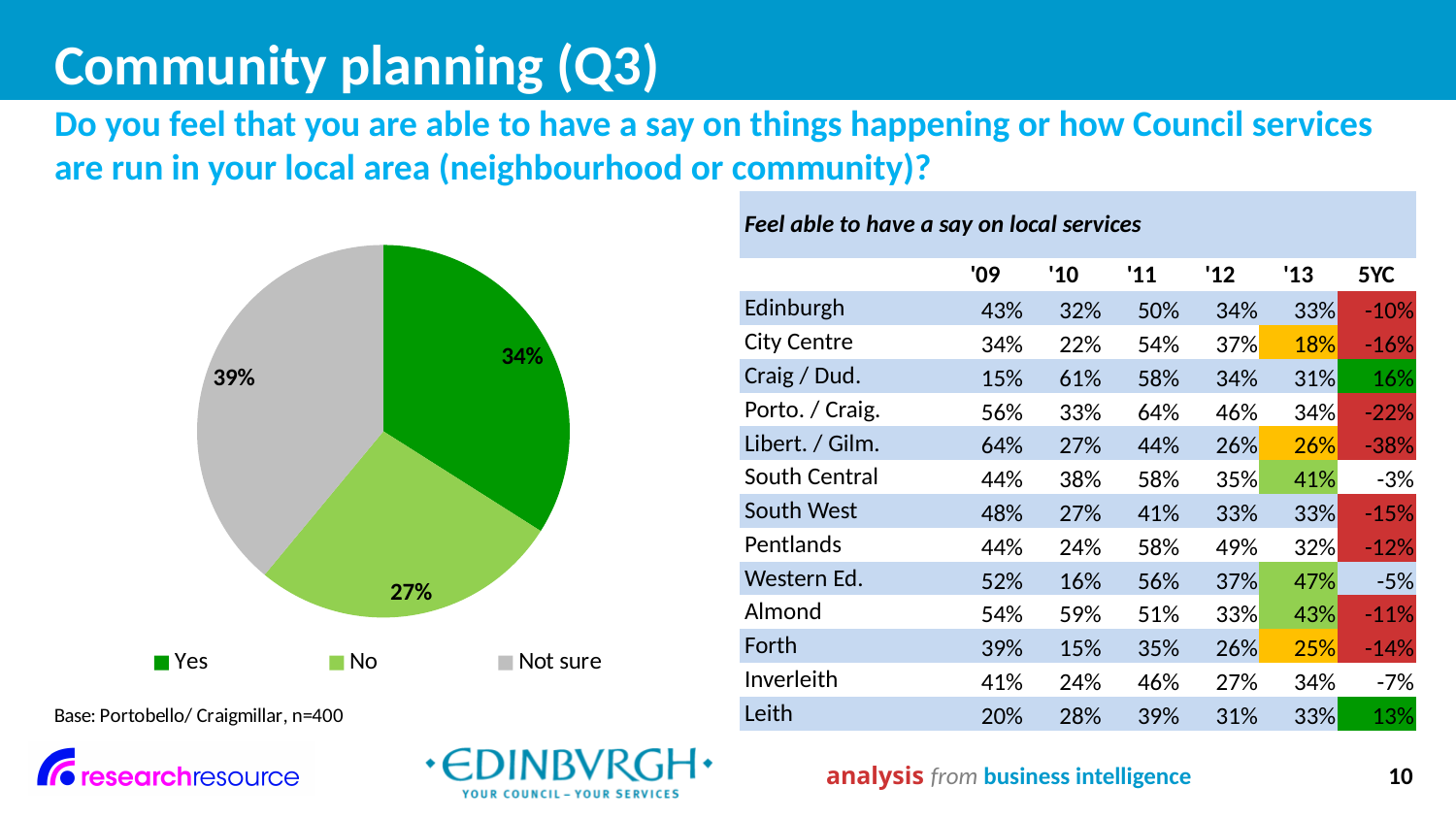
Which response has the largest share of the pie chart? Not sure How many slices does the pie chart have? 3 What percentage of respondents answered 'No' in the pie chart? 27% What is the difference in percentage points between 'Yes' and 'No' in the pie chart? 7 Which is larger in the pie chart, the 'Yes' share or the 'No' share? Yes How many entries does the pie chart legend list? 3 What is the base (sample size) stated below the pie chart? Portobello/ Craigmillar, n=400 What percentage of respondents answered 'Yes' in the pie chart? 34% Which response has the smallest share of the pie chart? No What percentage of respondents answered 'Not sure' in the pie chart? 39% What is the difference in percentage points between 'Not sure' and 'Yes' in the pie chart? 5 What kind of chart is shown on the slide? pie chart